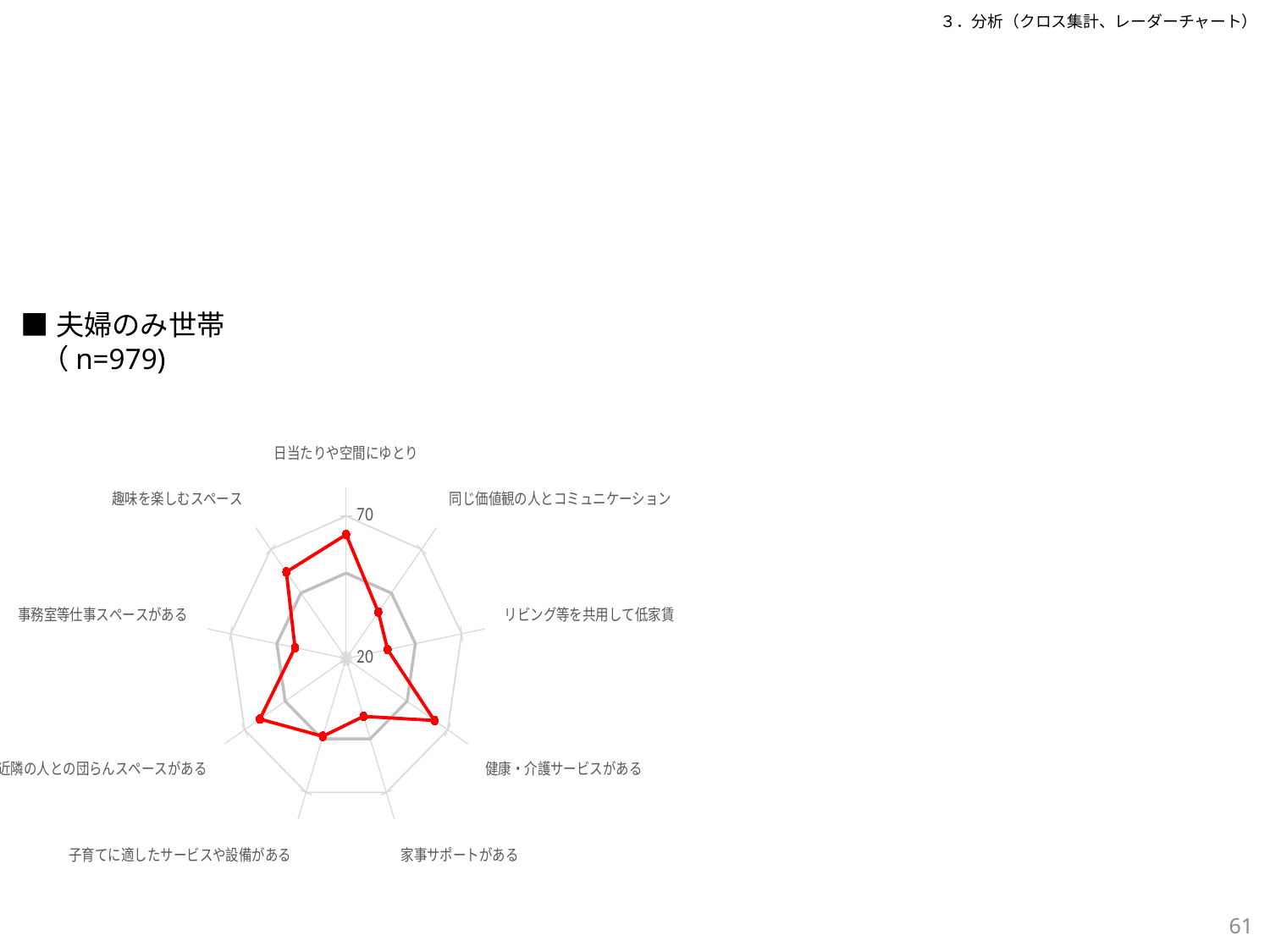
What kind of chart is shown on the slide? Radar chart Which is larger, the value for 日当たりや空間にゆとり or the value for リビング等を共用して低家賃? 日当たりや空間にゆとり Which is larger, the value for 趣味を楽しむスペース or the value for 同じ価値観の人とコミュニケーション? 趣味を楽しむスペース Is the value for 日当たりや空間にゆとり greater or less than 20? greater Is the value for 日当たりや空間にゆとり greater or less than 70? less How many categories (axes) does the radar chart have? 9 Is the value for 健康・介護サービスがある greater or less than 70? less Which is larger, the value for 健康・介護サービスがある or the value for 事務室等仕事スペースがある? 健康・介護サービスがある What is the sample size (n) shown for the chart? 979 Which household group does the chart describe, according to the heading? 夫婦のみ世帯